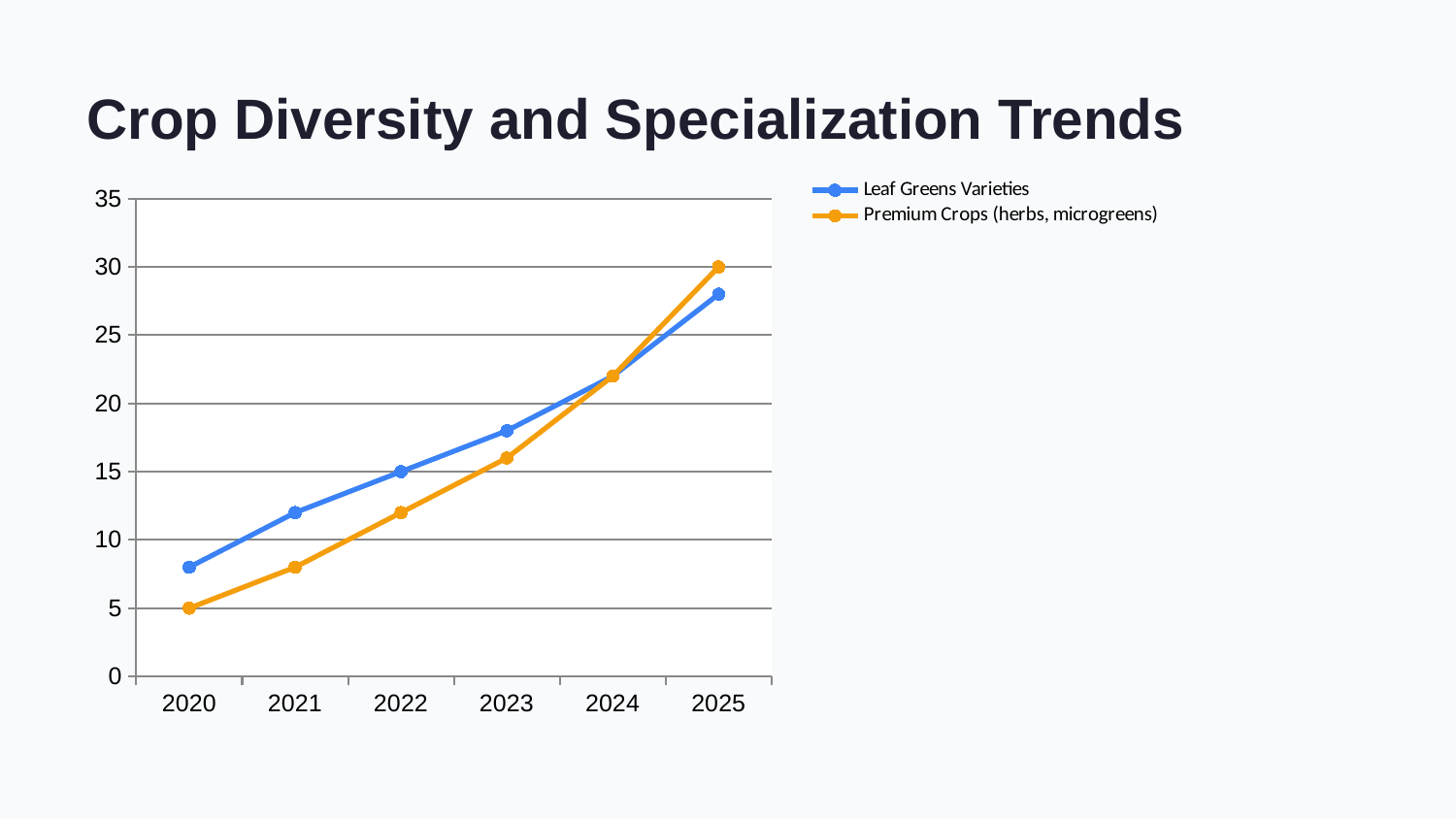
Is the value for Premium Crops (herbs, microgreens) in 2021 greater or less than 10? less What is the value for Premium Crops (herbs, microgreens) in 2020? 5 What is the value for Leaf Greens Varieties in 2022? 15 How many years are plotted along the x axis? 6 What kind of chart is shown on the slide? line chart In 2021, which series has the higher value, Leaf Greens Varieties or Premium Crops (herbs, microgreens)? Leaf Greens Varieties How many series does the legend list? 2 What is the value for Premium Crops (herbs, microgreens) in 2025? 30 Do the values for Premium Crops (herbs, microgreens) rise or fall from 2020 to 2025? rise Is the value for Leaf Greens Varieties in 2025 greater or less than 25? greater In 2025, which series has the higher value, Leaf Greens Varieties or Premium Crops (herbs, microgreens)? Premium Crops (herbs, microgreens) In which year is the value for Premium Crops (herbs, microgreens) lowest? 2020